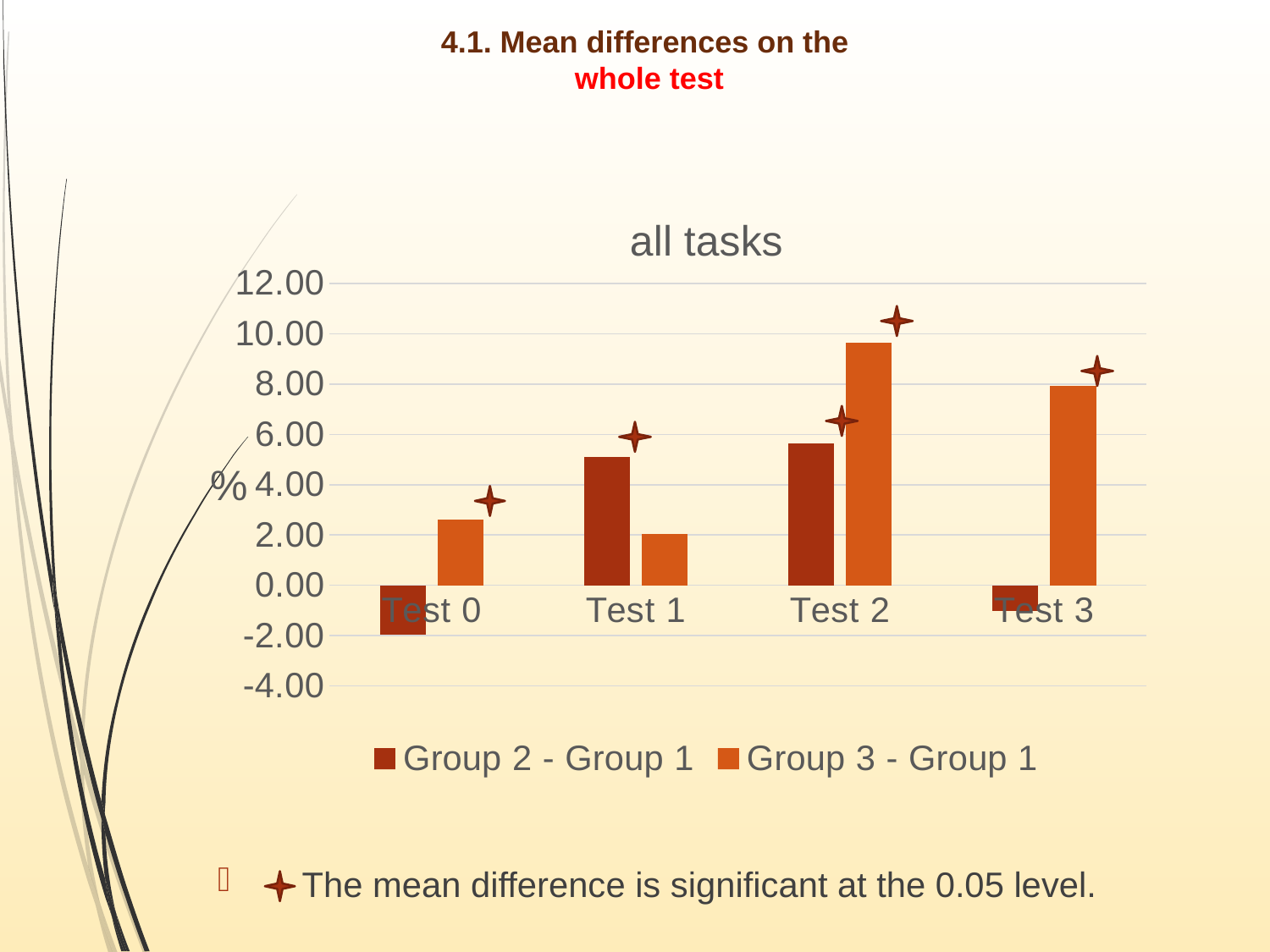
What kind of chart is shown on the slide? bar chart For which test is the Group 2 - Group 1 value lowest? Test 0 For which test is the Group 2 - Group 1 value highest? Test 2 How many test categories are shown on the x axis? 4 Which is larger for Test 1: the Group 2 - Group 1 value or the Group 3 - Group 1 value? Group 2 - Group 1 For which test is the Group 3 - Group 1 value highest? Test 2 Is the Group 3 - Group 1 value for Test 2 greater or less than 8.00? greater Is the Group 2 - Group 1 value for Test 0 greater or less than 0.00? less What label is shown on the vertical axis? % How many series does the legend list? 2 Which is larger for Test 3: the Group 2 - Group 1 value or the Group 3 - Group 1 value? Group 3 - Group 1 What is the title of the chart? all tasks